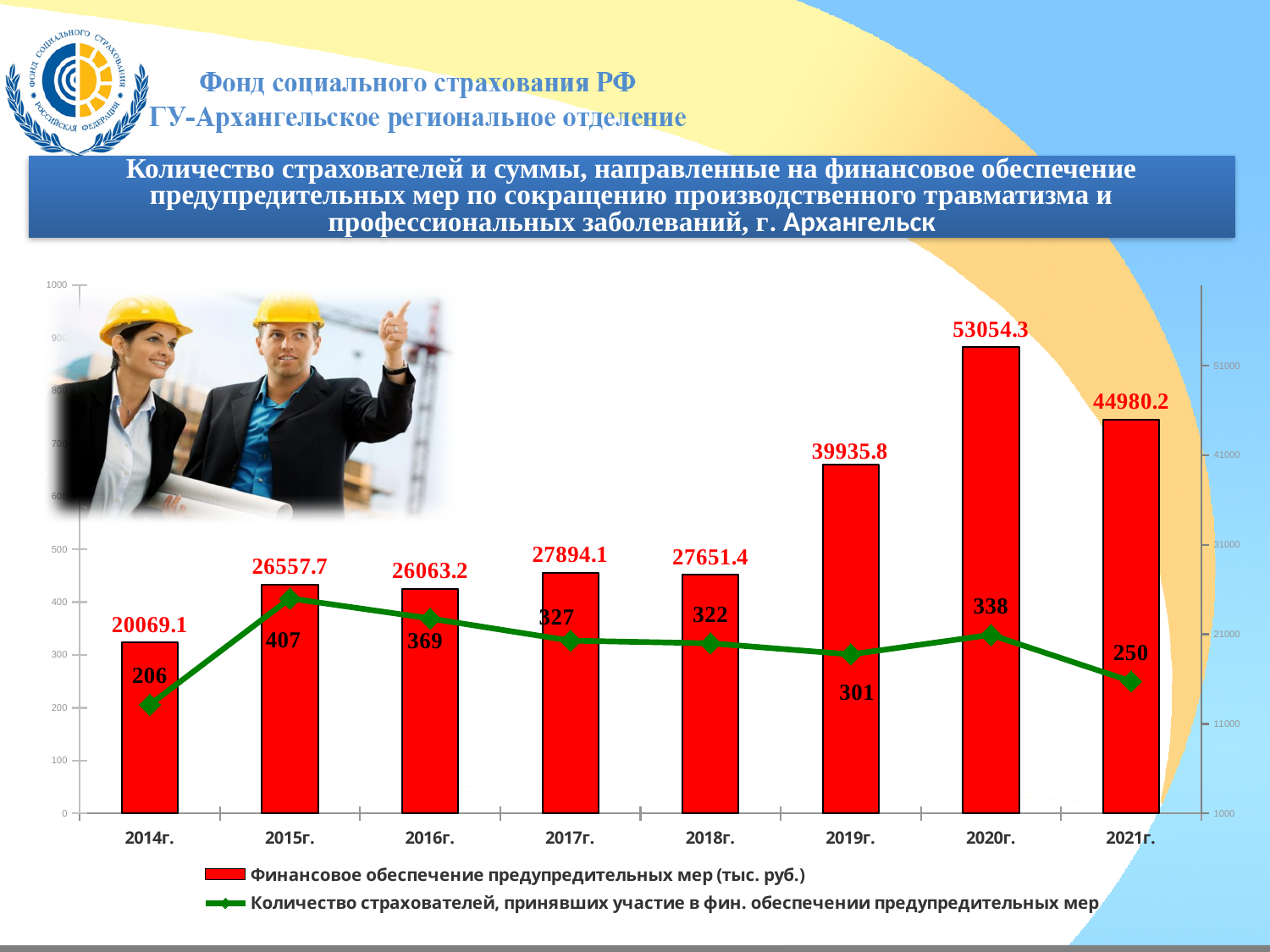
What is the value of 'Количество страхователей, принявших участие в фин. обеспечении предупредительных мер' for 2015г.? 407 What kind of chart is shown on the slide? Combined bar and line chart In which year is 'Финансовое обеспечение предупредительных мер (тыс. руб.)' the highest? 2020г. What colour are the bars for 'Финансовое обеспечение предупредительных мер (тыс. руб.)'? Red What is the difference between the 'Финансовое обеспечение предупредительных мер (тыс. руб.)' values for 2020г. and 2021г.? 8074.1 How many series does the chart legend list? 2 What is the value of 'Финансовое обеспечение предупредительных мер (тыс. руб.)' for 2014г.? 20069.1 Does 'Количество страхователей, принявших участие в фин. обеспечении предупредительных мер' rise or fall from 2020г. to 2021г.? Fall How many years are shown on the x axis of the chart? 8 What is the value of 'Финансовое обеспечение предупредительных мер (тыс. руб.)' for 2020г.? 53054.3 In which year is 'Количество страхователей, принявших участие в фин. обеспечении предупредительных мер' the lowest? 2014г. Which year has a larger 'Количество страхователей, принявших участие в фин. обеспечении предупредительных мер' value, 2016г. or 2019г.? 2016г.